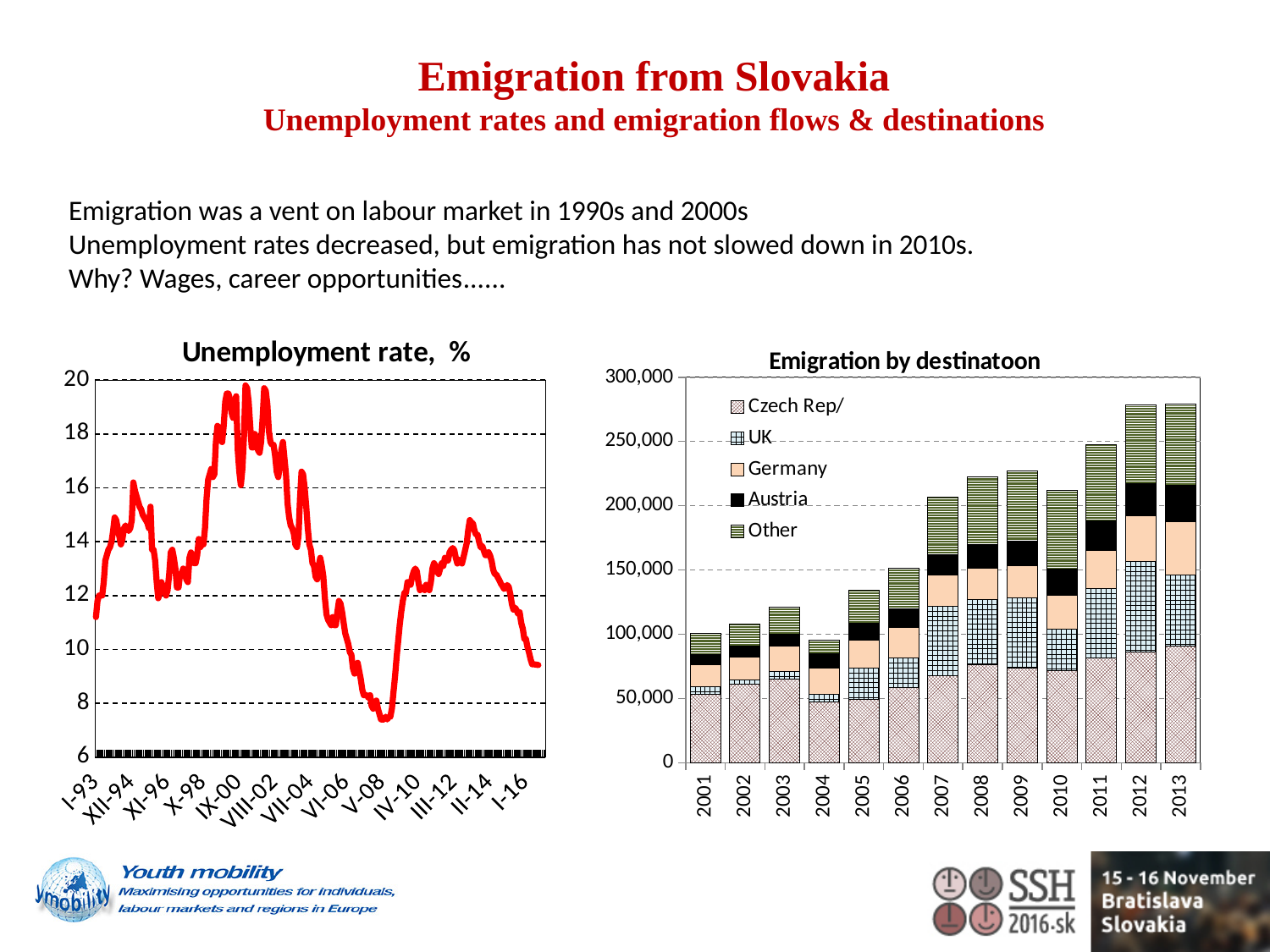
What kind of chart is the 'Emigration by destinatoon' chart on the right? stacked bar chart In the 'Emigration by destinatoon' chart, is the total for 2013 greater or less than 250,000? greater In the 'Unemployment rate, %' chart, does the unemployment rate rise or fall between II-14 and I-16? fall What kind of chart is the 'Unemployment rate, %' chart on the left? line chart In the 'Emigration by destinatoon' chart, which destination is listed first in the legend? Czech Rep/ In the 'Emigration by destinatoon' chart, is the total for 2004 greater or less than 100,000? less In the 'Emigration by destinatoon' chart, do total emigration flows generally rise or fall from 2001 to 2013? rise In the 'Emigration by destinatoon' chart, how many series does the legend list? 5 In the 'Emigration by destinatoon' chart, which year has the larger total emigration, 2005 or 2012? 2012 In the 'Emigration by destinatoon' chart, is the total for 2008 greater or less than 200,000? greater In the 'Emigration by destinatoon' chart, how many years (bars) are shown? 13